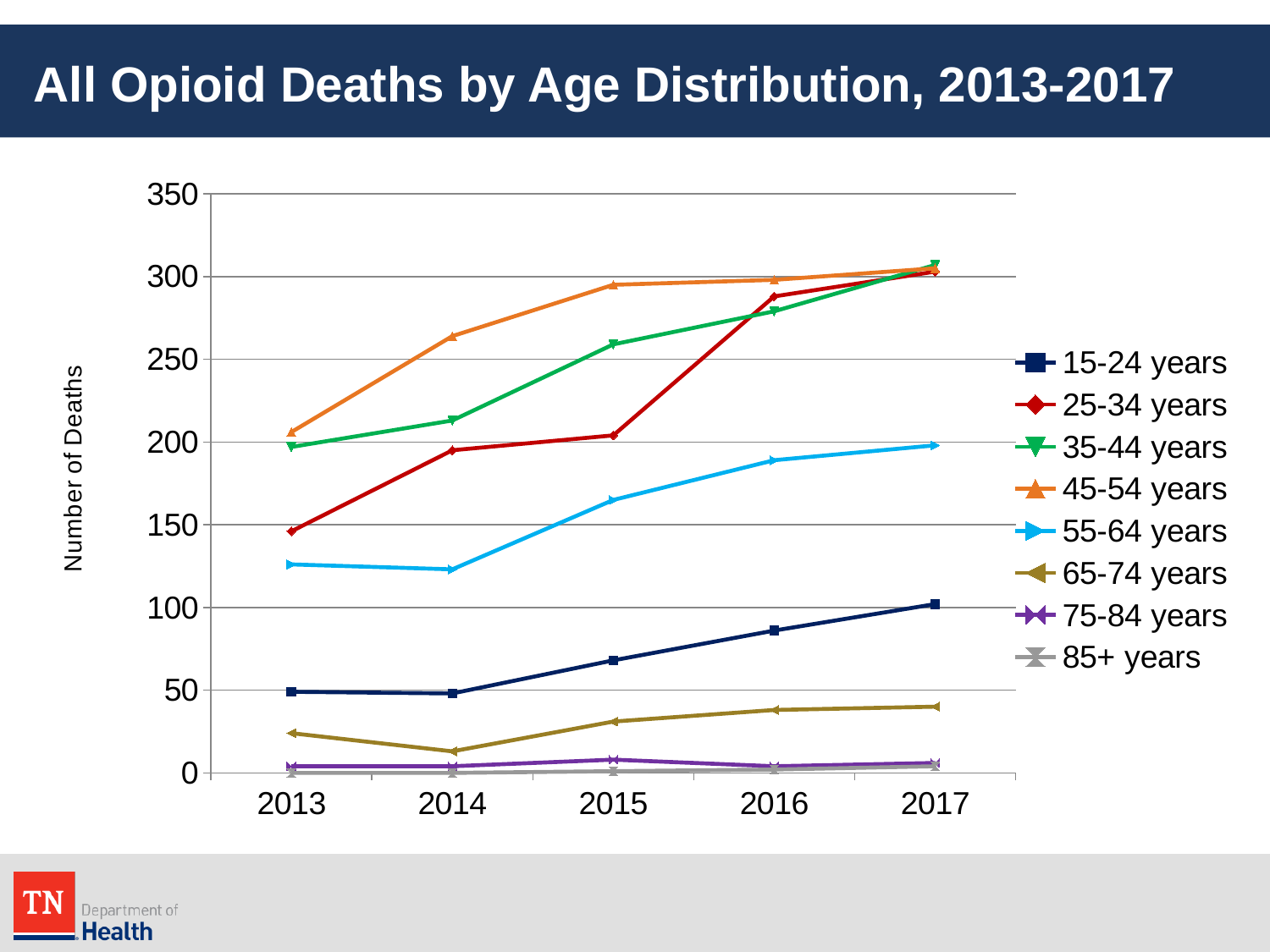
In 2015, which had more opioid deaths: 25-34 years or 35-44 years? 35-44 years Which age group had the highest number of opioid deaths in 2014? 45-54 years How many years are shown on the x axis? 5 What kind of chart is shown on the slide? line chart What is the title of the y axis? Number of Deaths Which age group had the lowest number of opioid deaths in 2013? 85+ years Is the value for 45-54 years in 2015 greater or less than 250? greater Is the value for 15-24 years in 2013 greater or less than 100? less Is the value for 55-64 years in 2016 greater or less than 150? greater How many age groups does the legend list? 8 Do the opioid deaths for 15-24 years rise or fall from 2014 to 2017? rise Which age group had the highest number of opioid deaths in 2013? 45-54 years